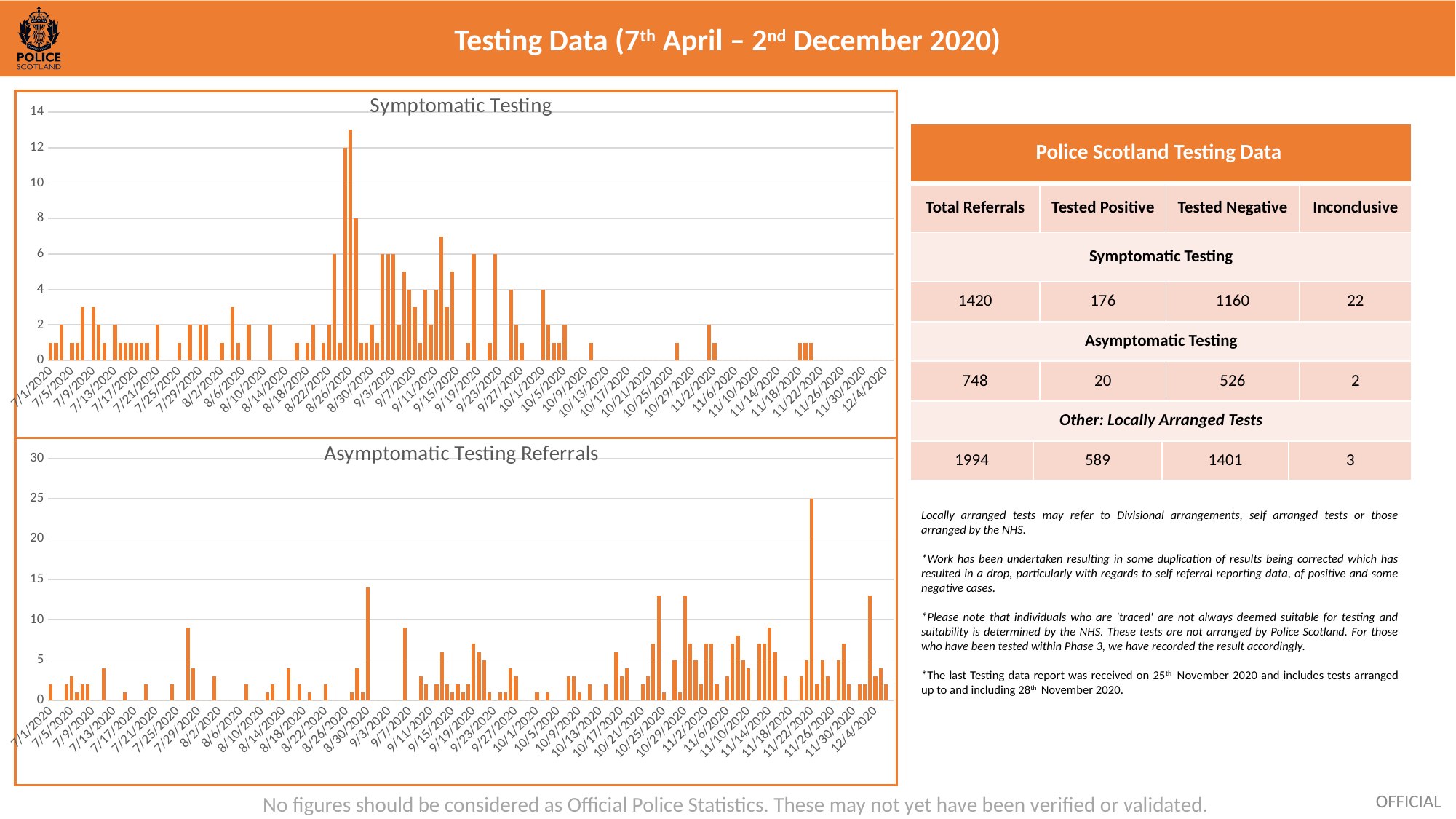
In the Symptomatic Testing chart, is the highest bar (around 8/26/2020) greater or less than 10? greater What is the title of the bottom chart on the slide? Asymptomatic Testing Referrals In the Asymptomatic Testing Referrals chart, is the highest bar (around 11/22/2020) greater or less than 20? greater In the Symptomatic Testing chart, is the bar at 7/9/2020 greater or less than 6? less In the Symptomatic Testing chart, which period has the highest bars: late August 2020 or late November 2020? late August 2020 In the Asymptomatic Testing Referrals chart, are the bars generally higher in July 2020 or in November 2020? November 2020 What kind of chart is the Symptomatic Testing chart? bar chart What is the title of the top chart on the slide? Symptomatic Testing What kind of chart is the Asymptomatic Testing Referrals chart? bar chart